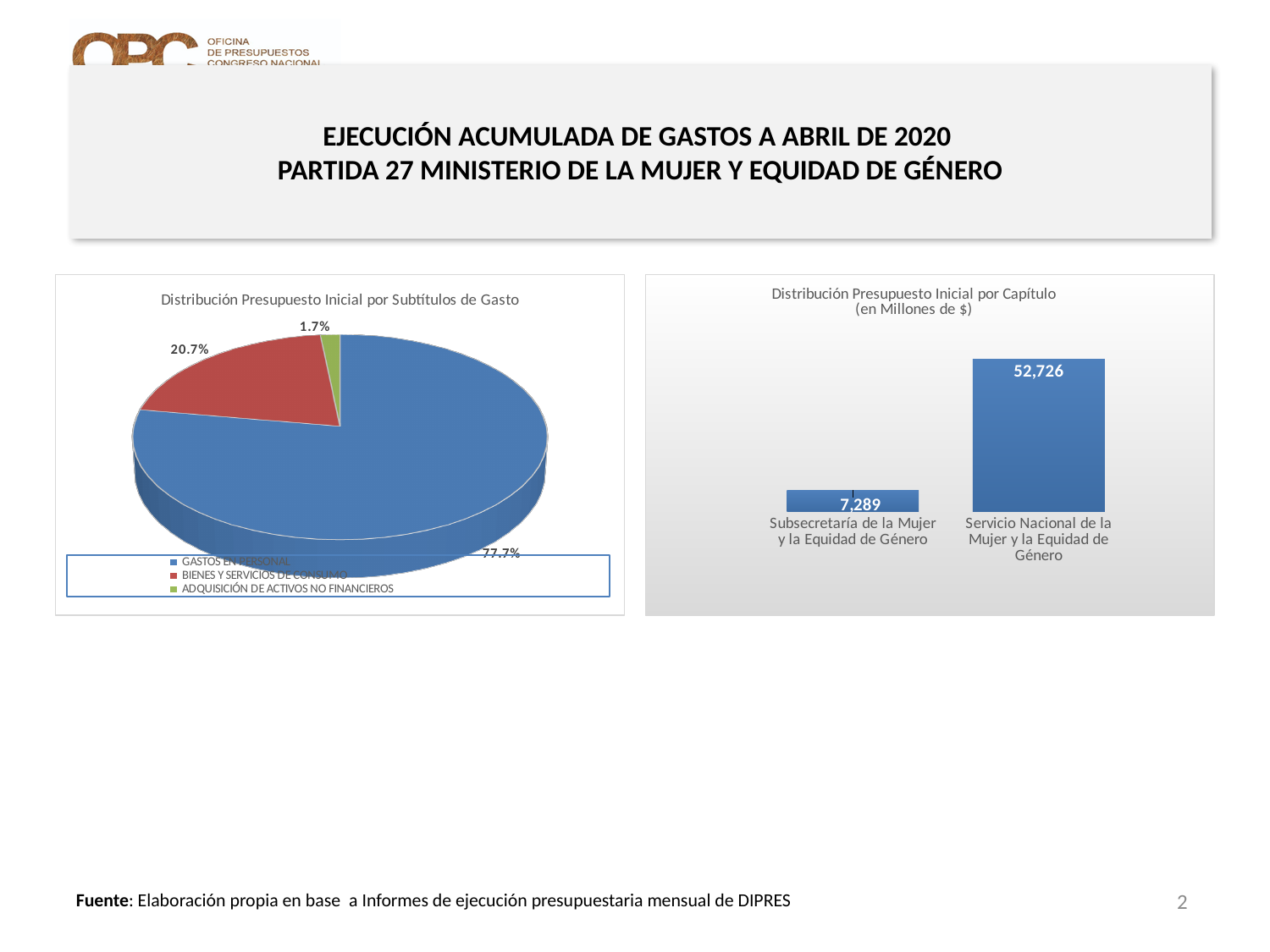
In the chart 'Distribución Presupuesto Inicial por Capítulo', which capítulo has the higher value? Servicio Nacional de la Mujer y la Equidad de Género In the chart 'Distribución Presupuesto Inicial por Subtítulos de Gasto', what share of the pie is GASTOS EN PERSONAL? 77.7% In the chart 'Distribución Presupuesto Inicial por Subtítulos de Gasto', what share of the pie is ADQUISICIÓN DE ACTIVOS NO FINANCIEROS? 1.7% In the chart 'Distribución Presupuesto Inicial por Subtítulos de Gasto', what share of the pie is BIENES Y SERVICIOS DE CONSUMO? 20.7% In the chart 'Distribución Presupuesto Inicial por Capítulo', what is the difference between the values for Servicio Nacional de la Mujer y la Equidad de Género and Subsecretaría de la Mujer y la Equidad de Género? 45,437 In the chart 'Distribución Presupuesto Inicial por Subtítulos de Gasto', which category has the largest slice? GASTOS EN PERSONAL What kind of chart is 'Distribución Presupuesto Inicial por Capítulo'? Bar chart In the chart 'Distribución Presupuesto Inicial por Subtítulos de Gasto', how many categories does the legend list? 3 In the chart 'Distribución Presupuesto Inicial por Capítulo', what is the value for Servicio Nacional de la Mujer y la Equidad de Género? 52,726 What kind of chart is 'Distribución Presupuesto Inicial por Subtítulos de Gasto'? Pie chart In the chart 'Distribución Presupuesto Inicial por Capítulo', what is the value for Subsecretaría de la Mujer y la Equidad de Género? 7,289 In the chart 'Distribución Presupuesto Inicial por Subtítulos de Gasto', which category has the smallest slice? ADQUISICIÓN DE ACTIVOS NO FINANCIEROS